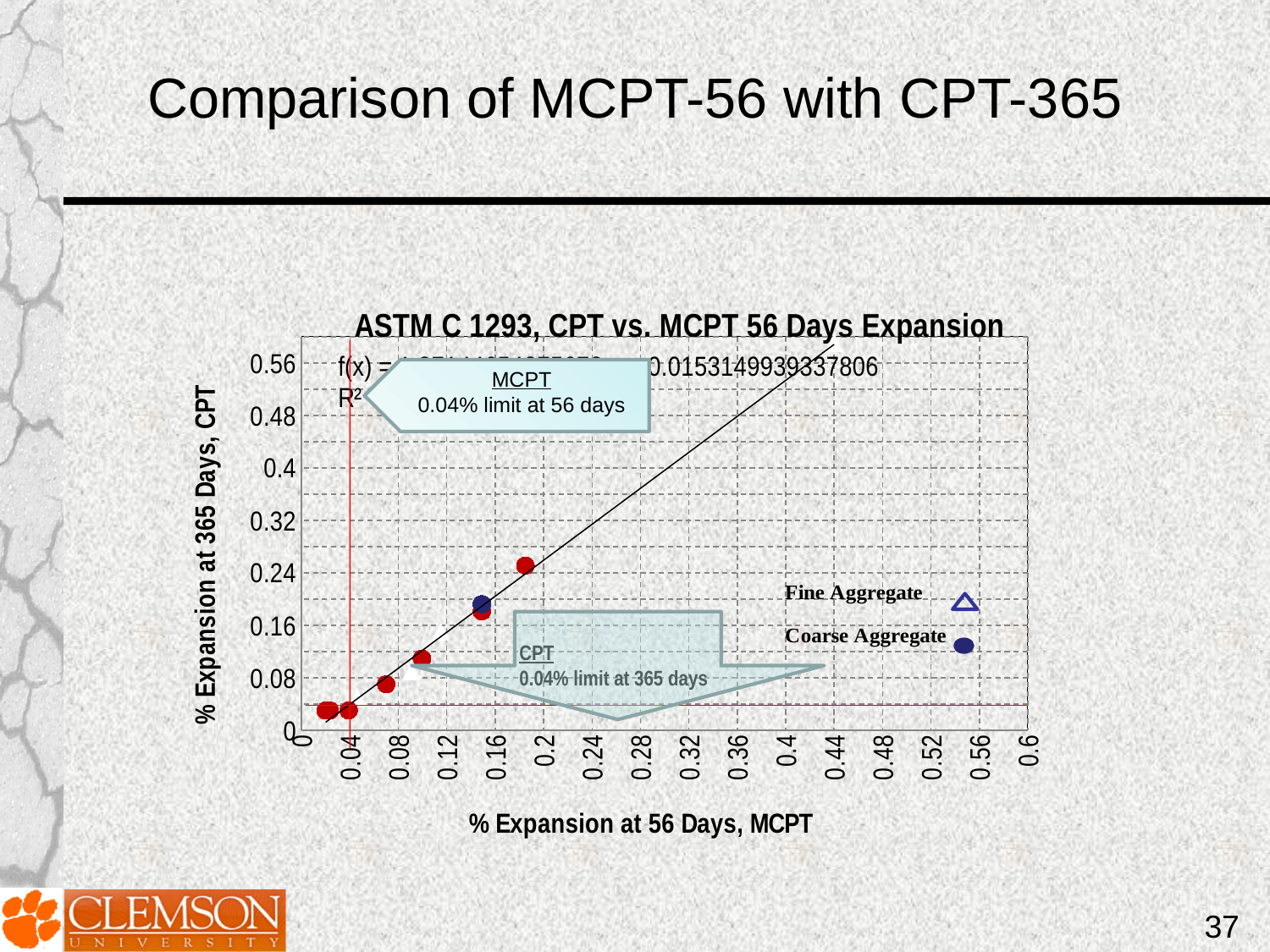
How many series does the chart's legend list? 2 Is the value of % Expansion at 365 Days, CPT for the point at about 0.1 on the x axis greater or less than 0.08? greater Is the highest plotted value of % Expansion at 365 Days, CPT greater or less than 0.16? greater Is the largest plotted value of % Expansion at 56 Days, MCPT greater or less than 0.24? less What kind of chart is shown on the slide? Scatter chart What is the title of the chart? ASTM C 1293, CPT vs. MCPT 56 Days Expansion What is the highest tick value shown on the y axis of the chart? 0.56 Which two series are listed in the chart's legend? Fine Aggregate and Coarse Aggregate Do the plotted values of % Expansion at 365 Days, CPT rise or fall as % Expansion at 56 Days, MCPT increases? Rise What is the highest tick value shown on the x axis of the chart? 0.6